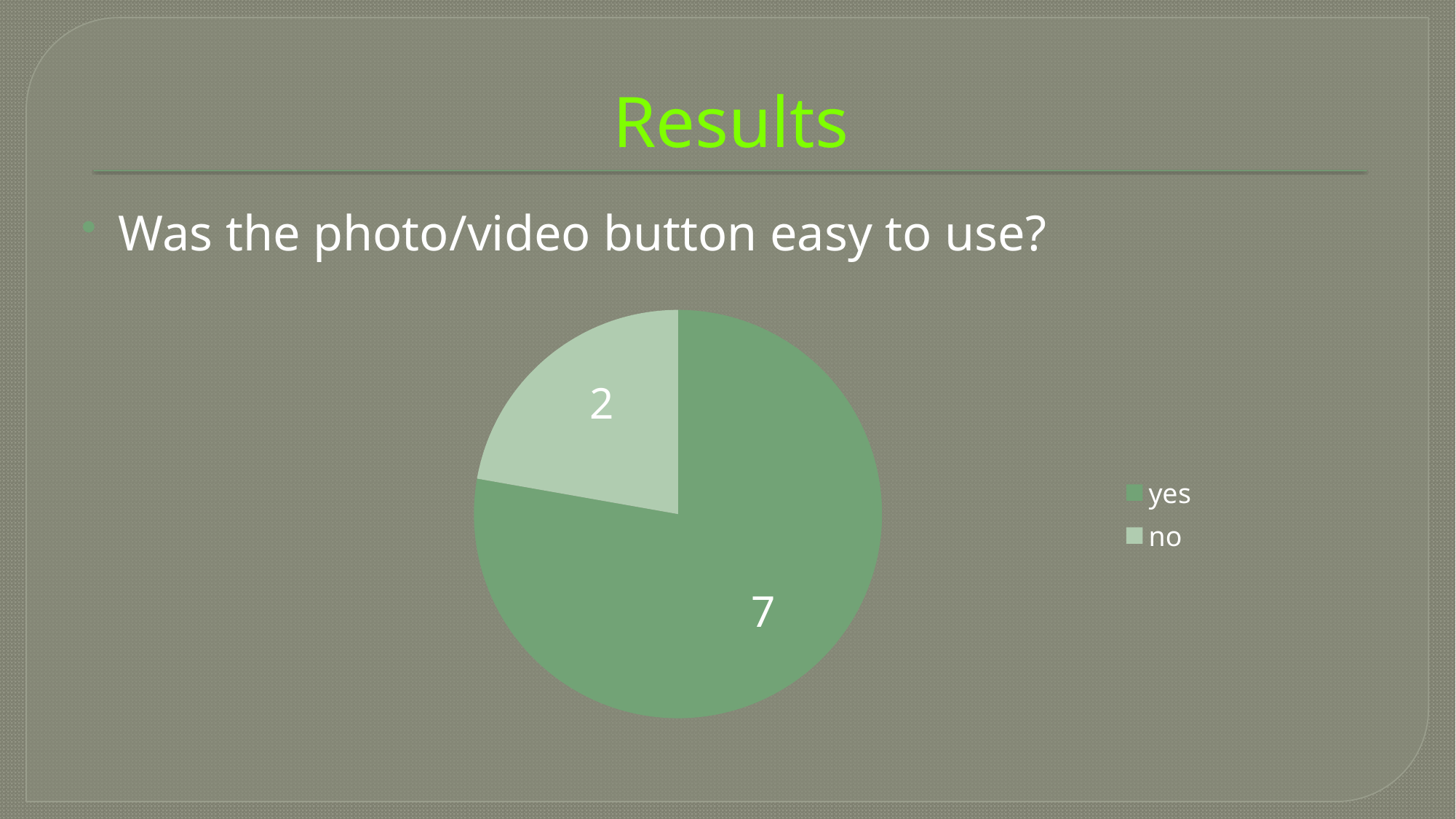
Which response has the smaller slice of the pie? no Which legend entry is shown in the lighter green colour? no What question does the pie chart present results for? Was the photo/video button easy to use? Which response has the larger slice of the pie? yes What type of chart is shown on the slide? pie chart What is the total number of responses shown in the pie chart? 9 Is the "yes" value larger or smaller than the "no" value? larger How many entries does the legend list? 2 How many slices does the pie chart have? 2 How many respondents answered "yes"? 7 How many respondents answered "no"? 2 What is the difference between the number of "yes" and "no" responses? 5